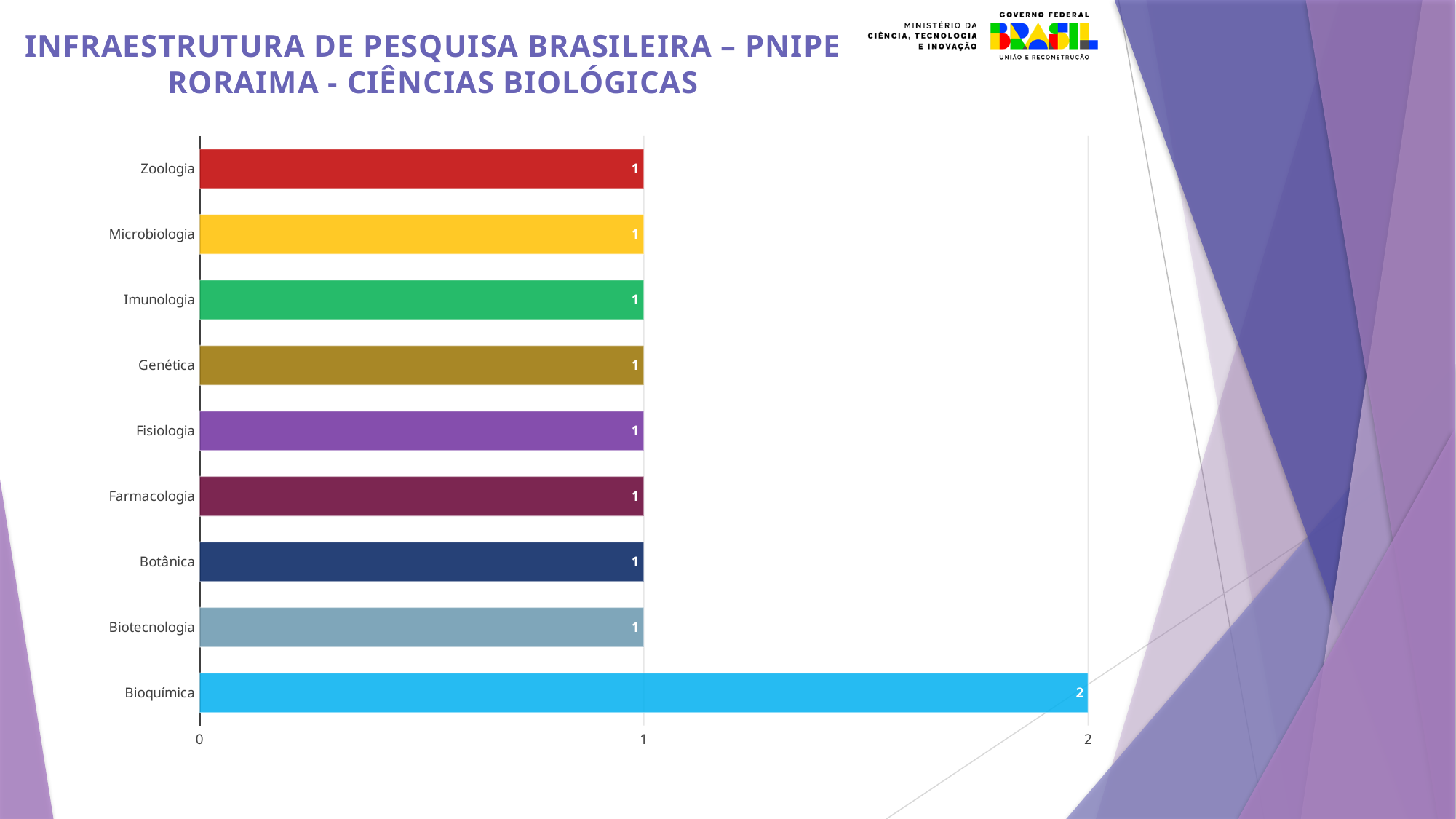
What is the total of all the values shown in the chart? 10 Which is larger, the value for Bioquímica or the value for Genética? Bioquímica What is the value for Zoologia? 1 What is the value for Farmacologia? 1 How many categories have a value of 1? 8 How many categories are shown in the chart? 9 What is the difference between the values for Bioquímica and Botânica? 1 What colour is the bar for Bioquímica? light blue What kind of chart is shown on the slide? bar chart What is the value for Bioquímica? 2 What is the value for Microbiologia? 1 Which category has the highest value? Bioquímica